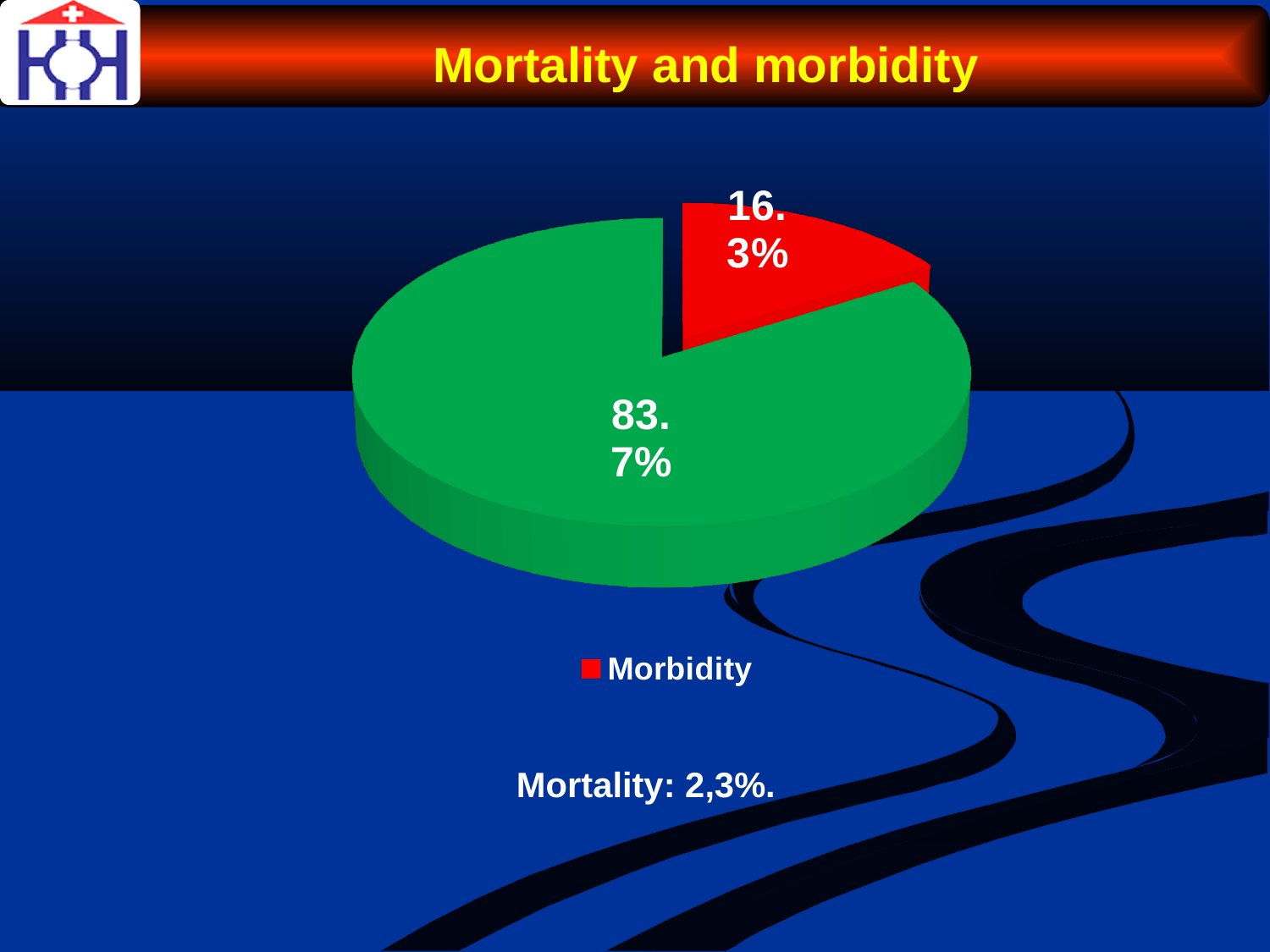
Is the green slice larger or smaller than the Morbidity slice? larger Which slice is the smallest in the pie chart? Morbidity How many entries does the legend list? 1 What share of the pie does the Morbidity slice represent? 16.3% What percentage is printed on the green slice of the pie? 83.7% How many slices does the pie chart have? 2 Which slice is the largest, the red Morbidity slice or the green slice? the green slice What is the difference in percentage points between the green slice and the Morbidity slice? 67.4 What percentage does the Morbidity slice show? 16.3% What colour is the Morbidity slice in the pie chart? red What kind of chart is shown on the slide? pie chart What is the title of the slide containing the pie chart? Mortality and morbidity